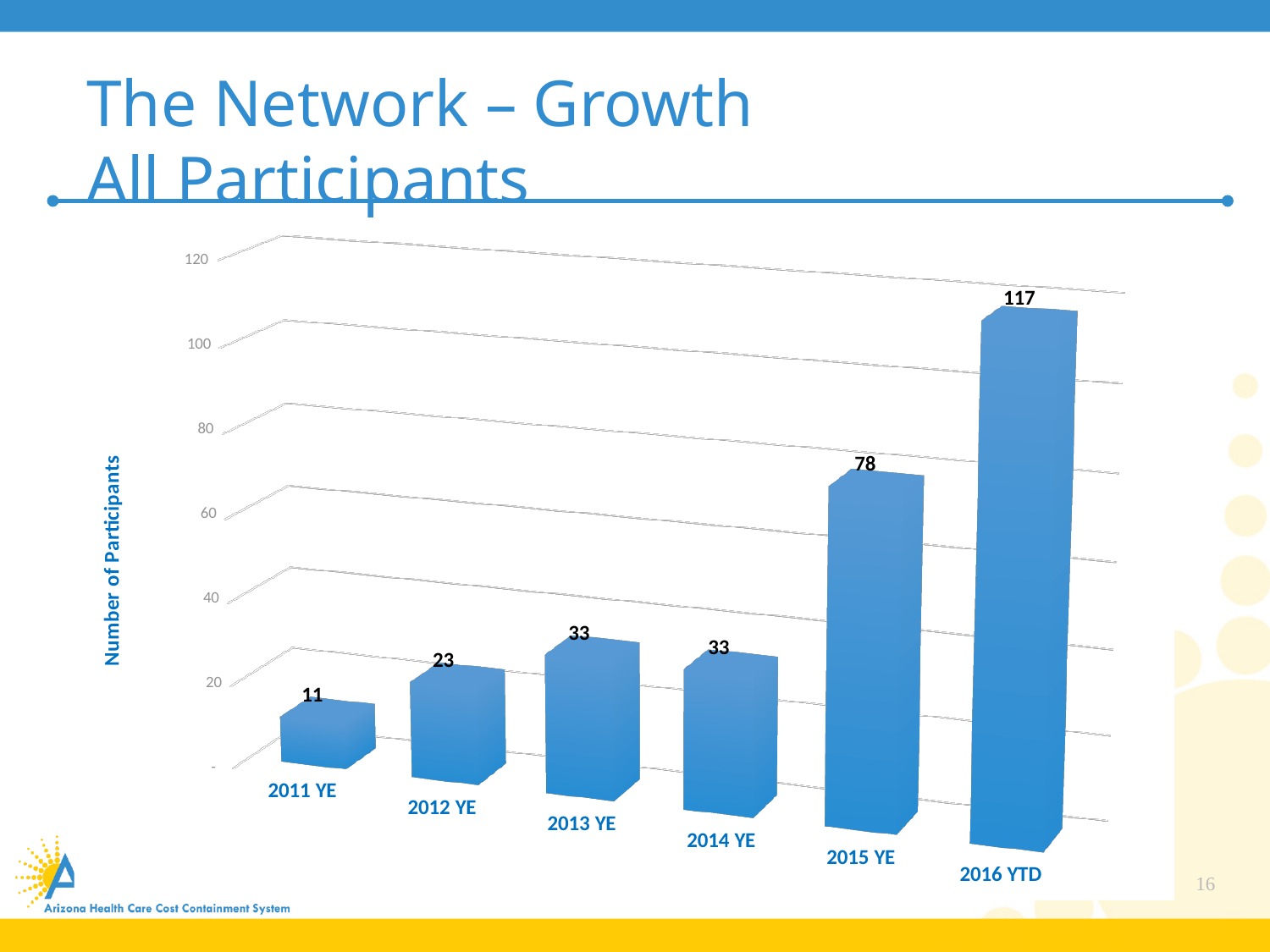
How many categories are shown on the x axis? 6 What kind of chart is shown on the slide? bar chart What is the number of participants for 2011 YE? 11 What is the number of participants for 2015 YE? 78 Which category has the lowest number of participants? 2011 YE What is the label of the vertical axis? Number of Participants Do the values generally rise or fall from 2011 YE to 2016 YTD? rise What is the number of participants for 2016 YTD? 117 Which category has the highest number of participants? 2016 YTD Which has more participants, 2014 YE or 2015 YE? 2015 YE What is the difference in participants between 2012 YE and 2011 YE? 12 What is the difference in participants between 2016 YTD and 2015 YE? 39